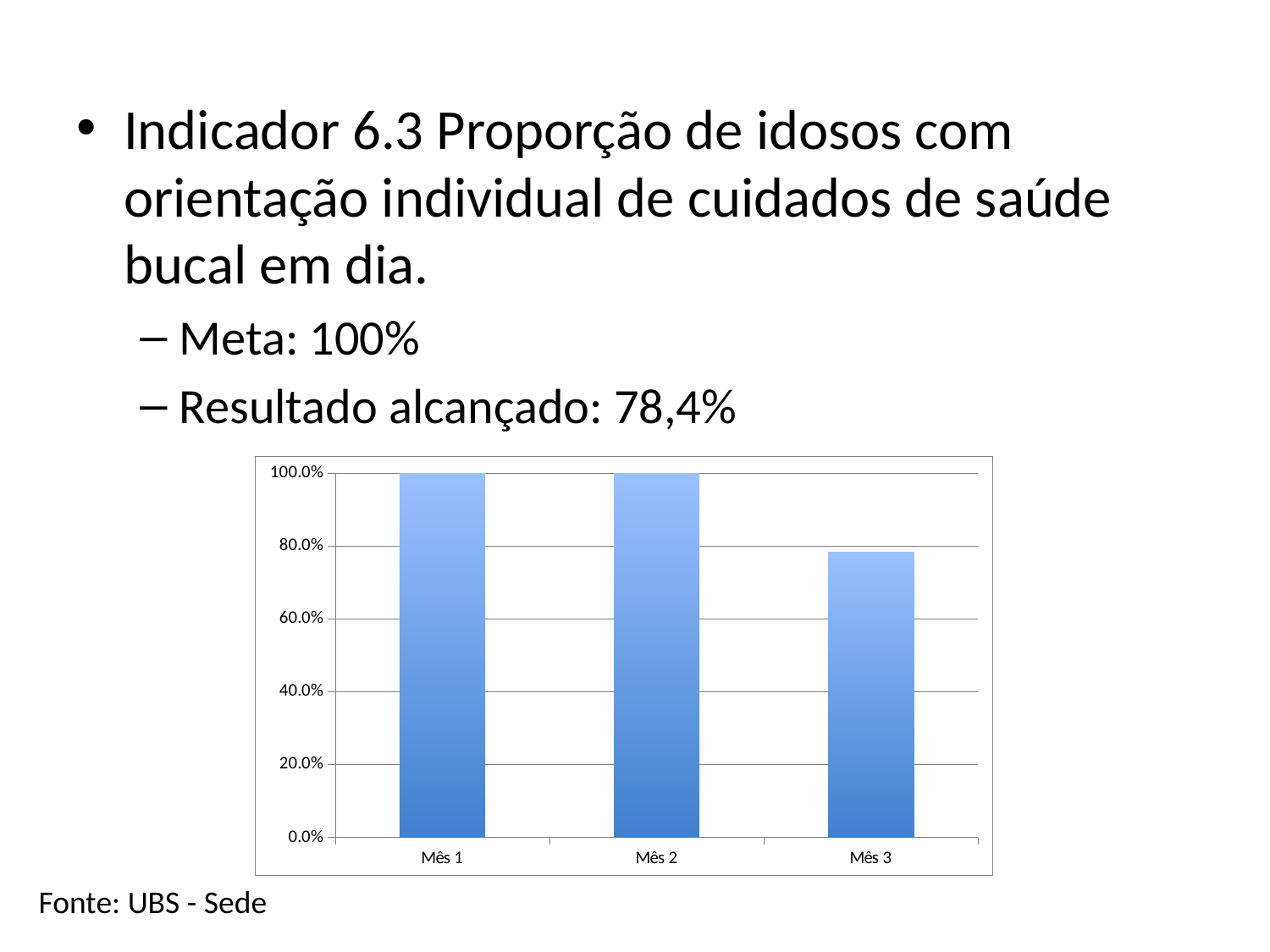
What is the value for Mês 1 in the chart? 100.0% How many categories are shown on the x axis of the chart? 3 What kind of chart is shown on the slide? bar chart What source is cited below the chart? UBS - Sede Is the value for Mês 3 greater or less than 60.0%? greater What is the highest tick label shown on the y axis of the chart? 100.0% Which is larger, the value for Mês 1 or the value for Mês 3? Mês 1 Is the value for Mês 3 greater or less than 80.0%? less Which category has the lowest value in the chart? Mês 3 Do the values rise or fall from Mês 1 to Mês 3? fall Which is larger, the value for Mês 2 or the value for Mês 3? Mês 2